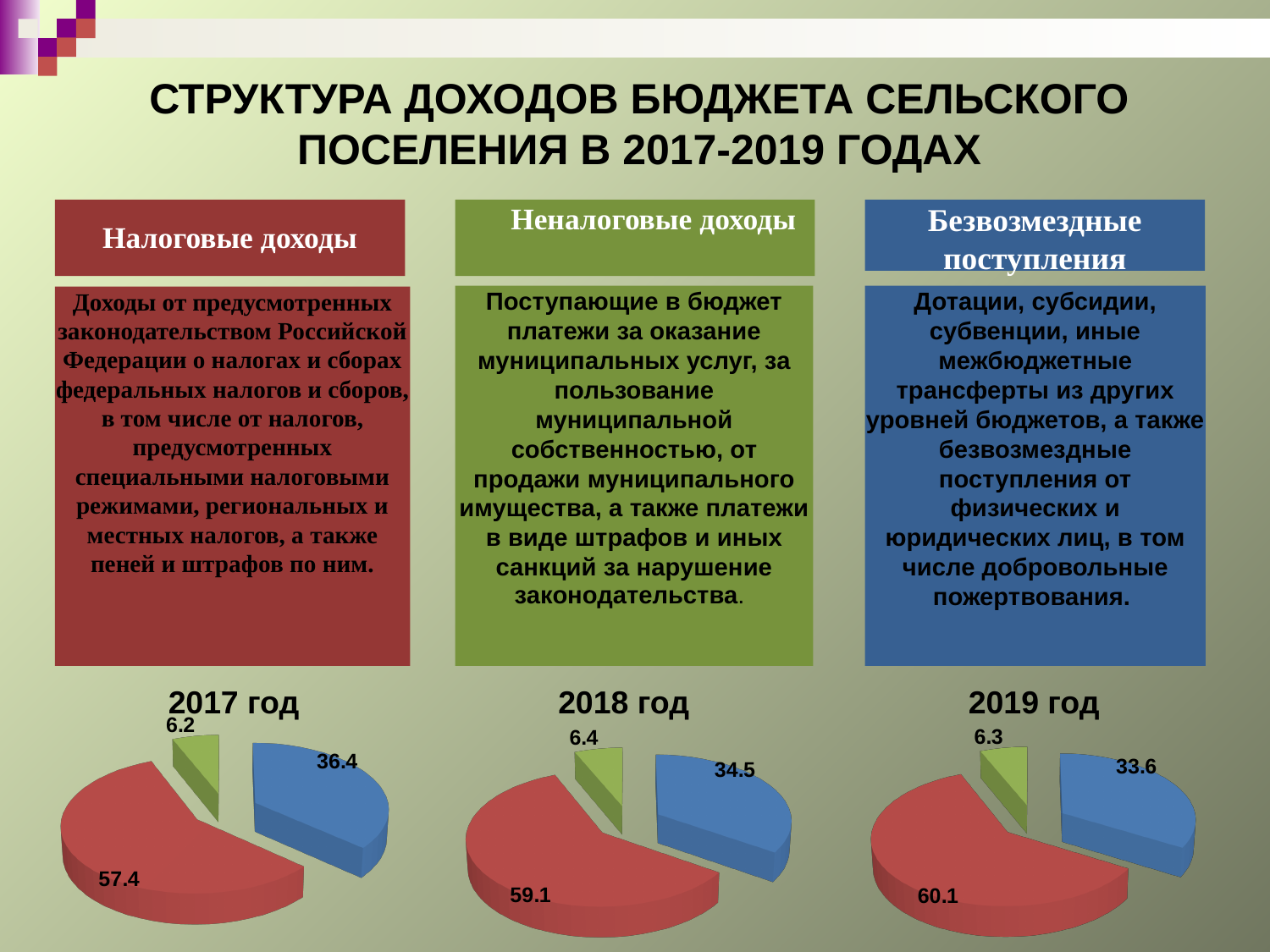
In the "2017 год" chart, what is the difference between the red slice (57.4) and the blue slice (36.4)? 21 How many slices does the "2018 год" pie chart have? 3 Which chart has the larger blue slice value, "2017 год" or "2018 год"? 2017 год In the "2019 год" chart, what is the value of the largest slice? 60.1 In the "2019 год" chart, what is the value of the green slice? 6.3 In the "2019 год" chart, what is the difference between the blue slice (33.6) and the green slice (6.3)? 27.3 In the "2018 год" chart, what is the value of the blue slice? 34.5 How many pie charts are shown on the slide? 3 What kind of chart is the "2017 год" chart? pie chart Which chart has the larger red slice value, "2018 год" or "2019 год"? 2019 год In the "2017 год" chart, what is the value of the smallest slice? 6.2 Does the value of the largest (red) slice rise or fall from the 2017 chart to the 2019 chart? rises